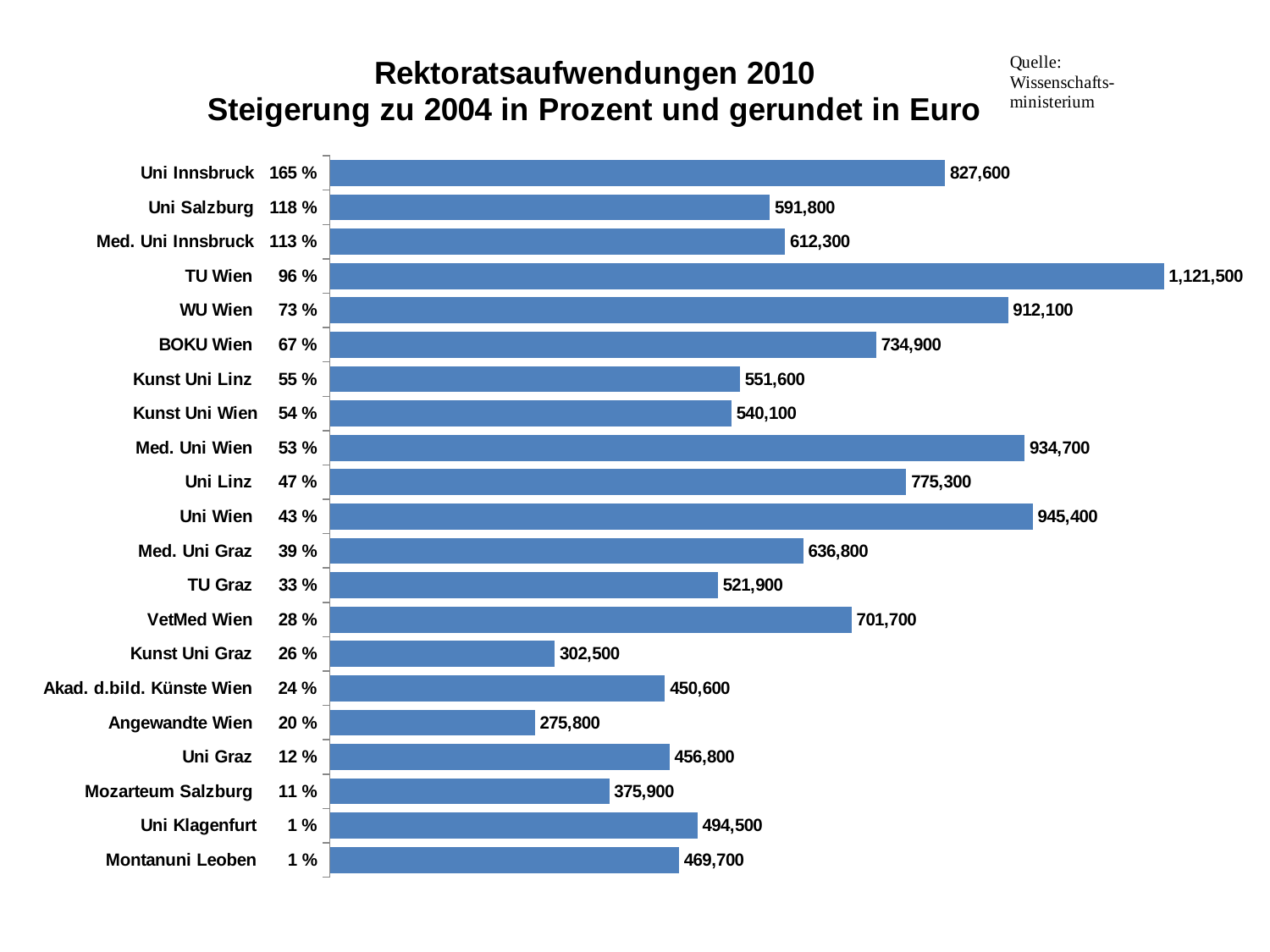
What is the difference in Euro between TU Wien and Uni Wien? 176,100 What is the title of the chart? Rektoratsaufwendungen 2010 Steigerung zu 2004 in Prozent und gerundet in Euro What is the value in Euro shown for Uni Klagenfurt? 494,500 What is the difference in Euro between Uni Innsbruck and Uni Salzburg? 235,800 How many universities are shown in the chart? 21 Which has the larger value in Euro, WU Wien or Med. Uni Wien? Med. Uni Wien What is the value in Euro shown for Mozarteum Salzburg? 375,900 What kind of chart is shown on the slide? bar chart Which university has the lowest value in Euro? Angewandte Wien What percentage increase is shown for Uni Innsbruck? 165 % What is the value in Euro shown for TU Wien? 1,121,500 Which university has the highest value in Euro? TU Wien